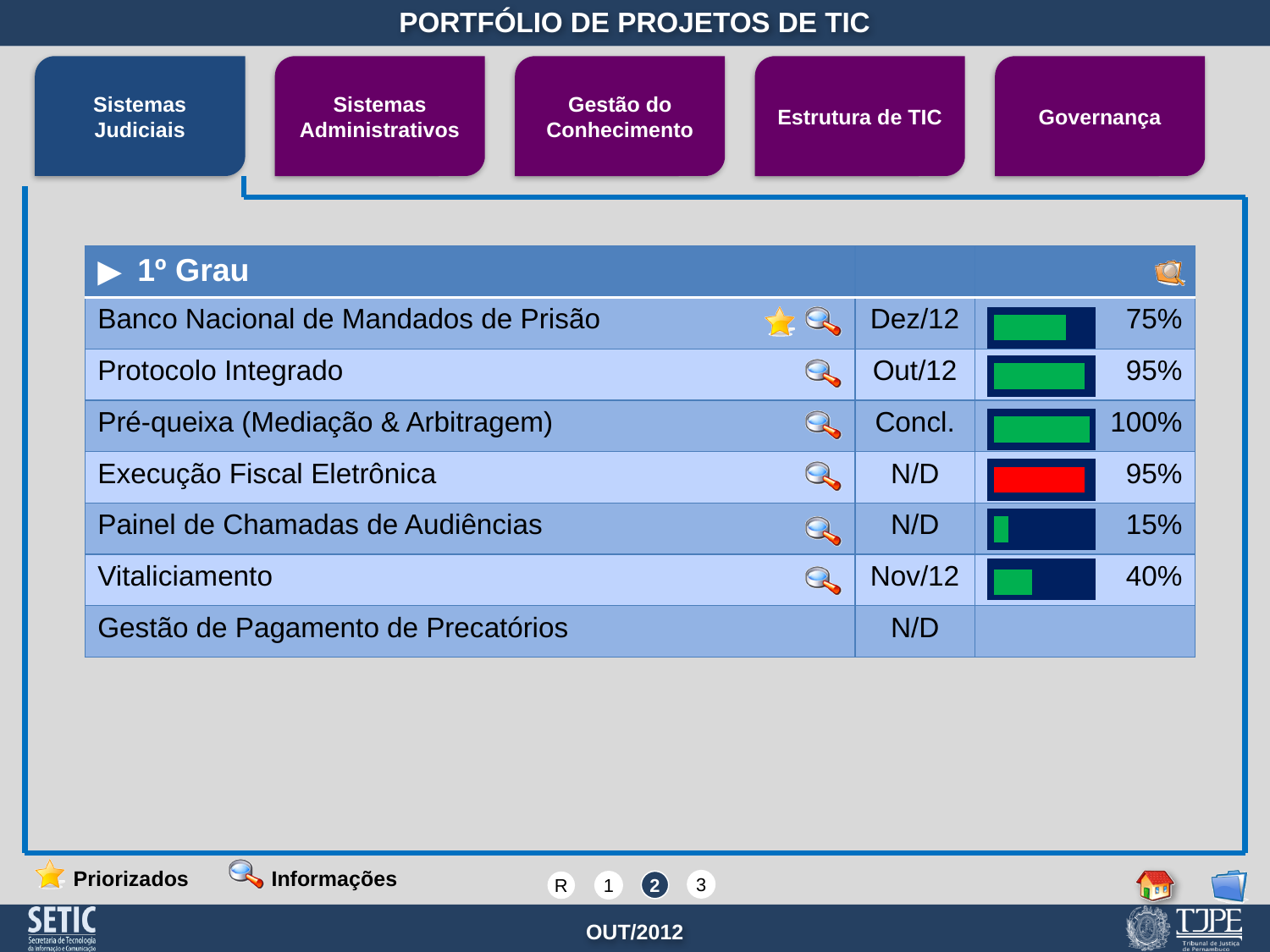
How many projects in the 1º Grau table have a progress bar shown? 6 What is the completion percentage shown for Painel de Chamadas de Audiências? 15% What is the difference in completion percentage between Protocolo Integrado and Vitaliciamento? 55% Which project's progress bar is coloured red? Execução Fiscal Eletrônica Which project in the 1º Grau table has the highest completion percentage? Pré-queixa (Mediação & Arbitragem) Which project in the 1º Grau table has the lowest completion percentage? Painel de Chamadas de Audiências What is the completion percentage shown for Banco Nacional de Mandados de Prisão? 75% What is the deadline shown for Protocolo Integrado? Out/12 Which has a higher completion percentage, Banco Nacional de Mandados de Prisão or Execução Fiscal Eletrônica? Execução Fiscal Eletrônica What is the difference in completion percentage between Pré-queixa (Mediação & Arbitragem) and Banco Nacional de Mandados de Prisão? 25% What kind of chart is used to show project progress in the 1º Grau table? Bar chart What is the completion percentage shown for Vitaliciamento? 40%